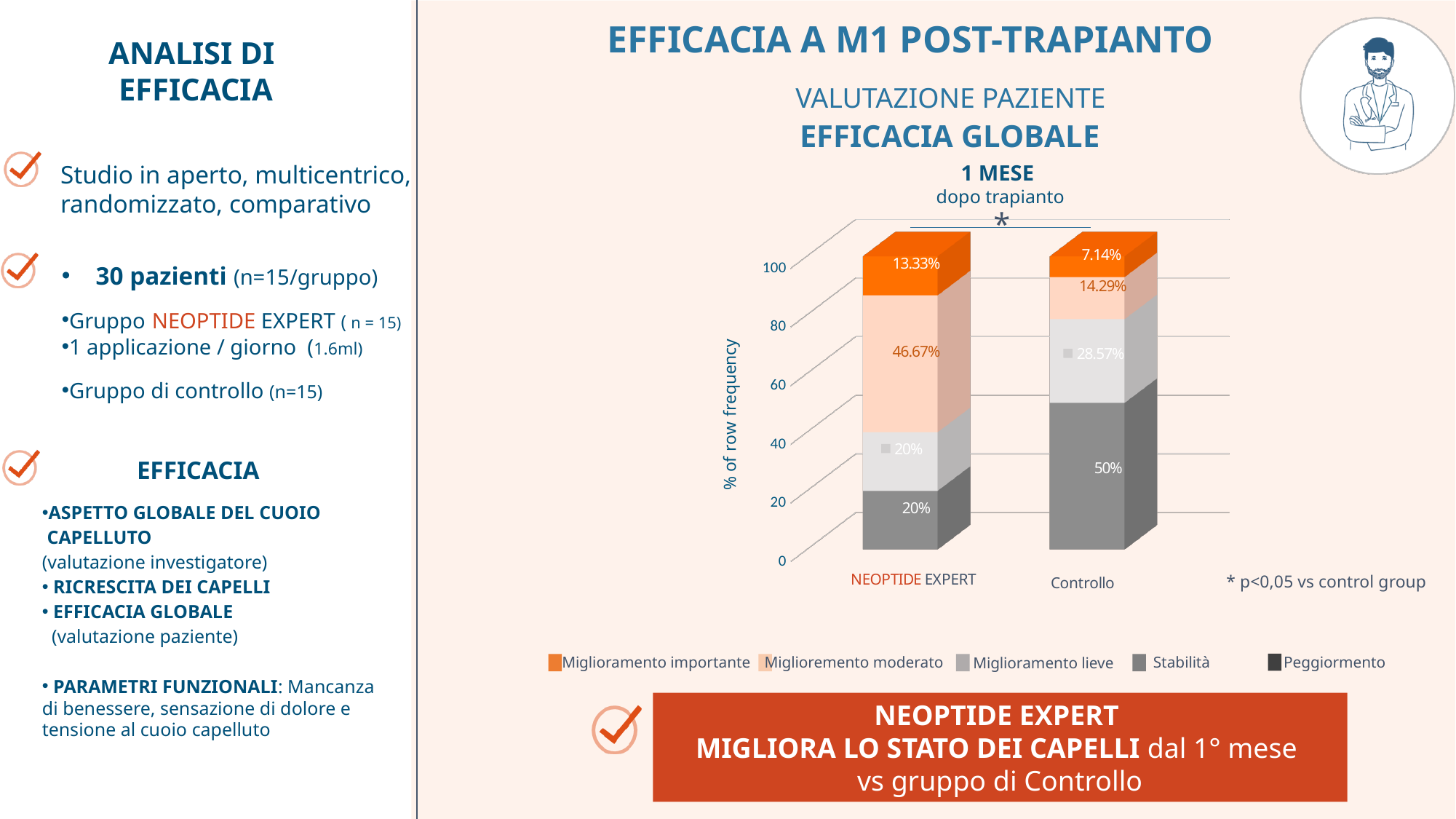
What is the value of 'Stabilità' for the Controllo group? 50% What is the value of 'Miglioramento importante' for the Controllo group? 7.14% What kind of chart is shown on the slide? stacked bar chart What is the value of 'Miglioremento moderato' for NEOPTIDE EXPERT? 46.67% Which segment is the largest in the NEOPTIDE EXPERT bar? Miglioremento moderato Which group has the larger 'Miglioremento moderato' value, NEOPTIDE EXPERT or Controllo? NEOPTIDE EXPERT What is the value of 'Miglioramento importante' for NEOPTIDE EXPERT? 13.33% What is the difference between the 'Stabilità' values of Controllo and NEOPTIDE EXPERT? 30% What is the value of 'Miglioramento lieve' for the Controllo group? 28.57% What is the label of the y axis of the chart? % of row frequency How many categories (groups) are plotted on the x axis of the chart? 2 How many series does the chart legend list? 5